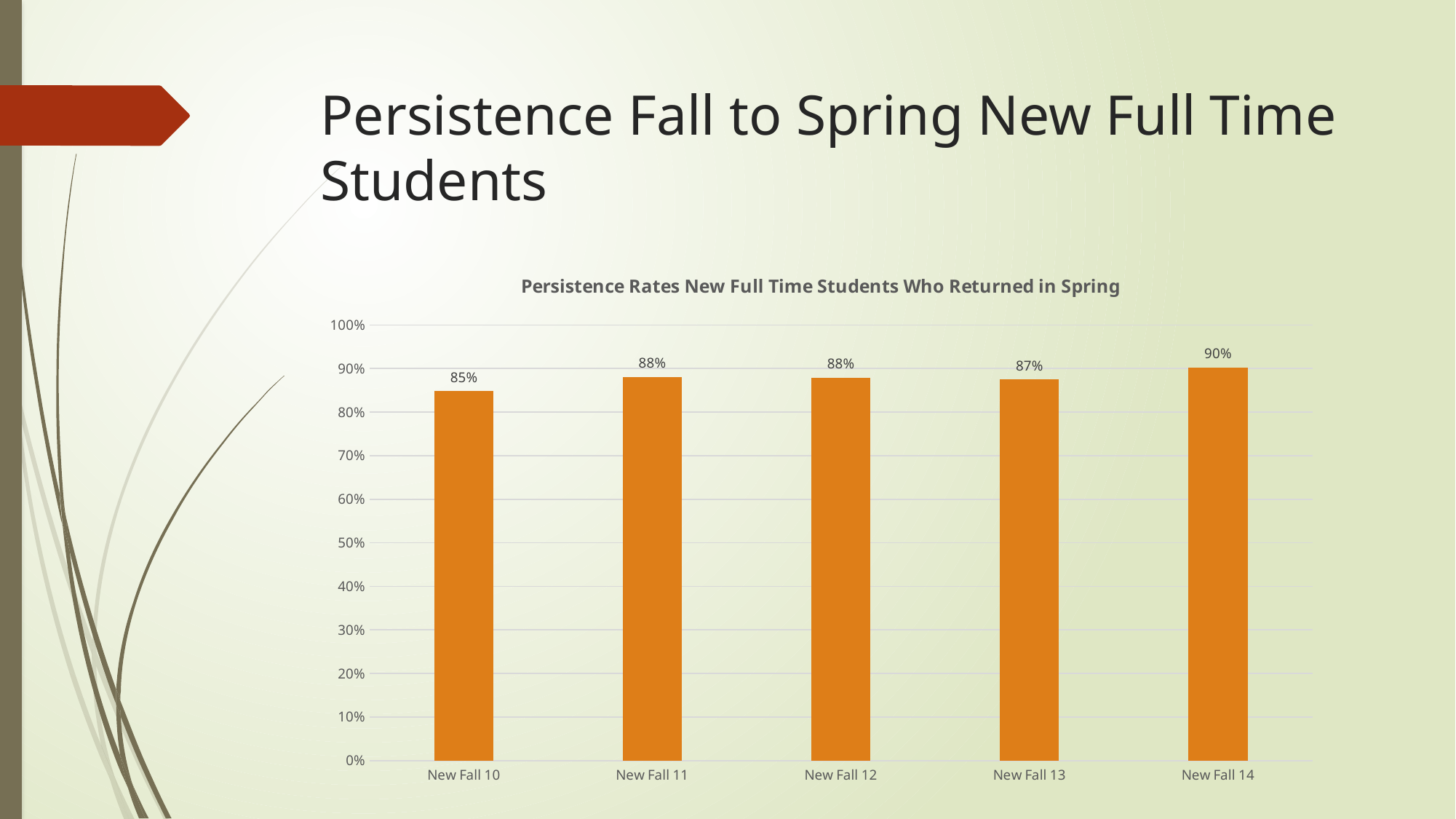
What is the persistence rate for New Fall 10? 85% What is the persistence rate for New Fall 14? 90% Which category has the highest persistence rate? New Fall 14 What is the title of the chart? Persistence Rates New Full Time Students Who Returned in Spring Is the value for New Fall 14 greater or less than 80%? greater Which has a higher persistence rate, New Fall 10 or New Fall 12? New Fall 12 What is the difference between the persistence rates for New Fall 14 and New Fall 10? 5% What is the persistence rate for New Fall 13? 87% What is the difference between the persistence rates for New Fall 11 and New Fall 13? 1% How many categories are shown on the x axis? 5 What kind of chart is shown on the slide? Bar chart Which category has the lowest persistence rate? New Fall 10